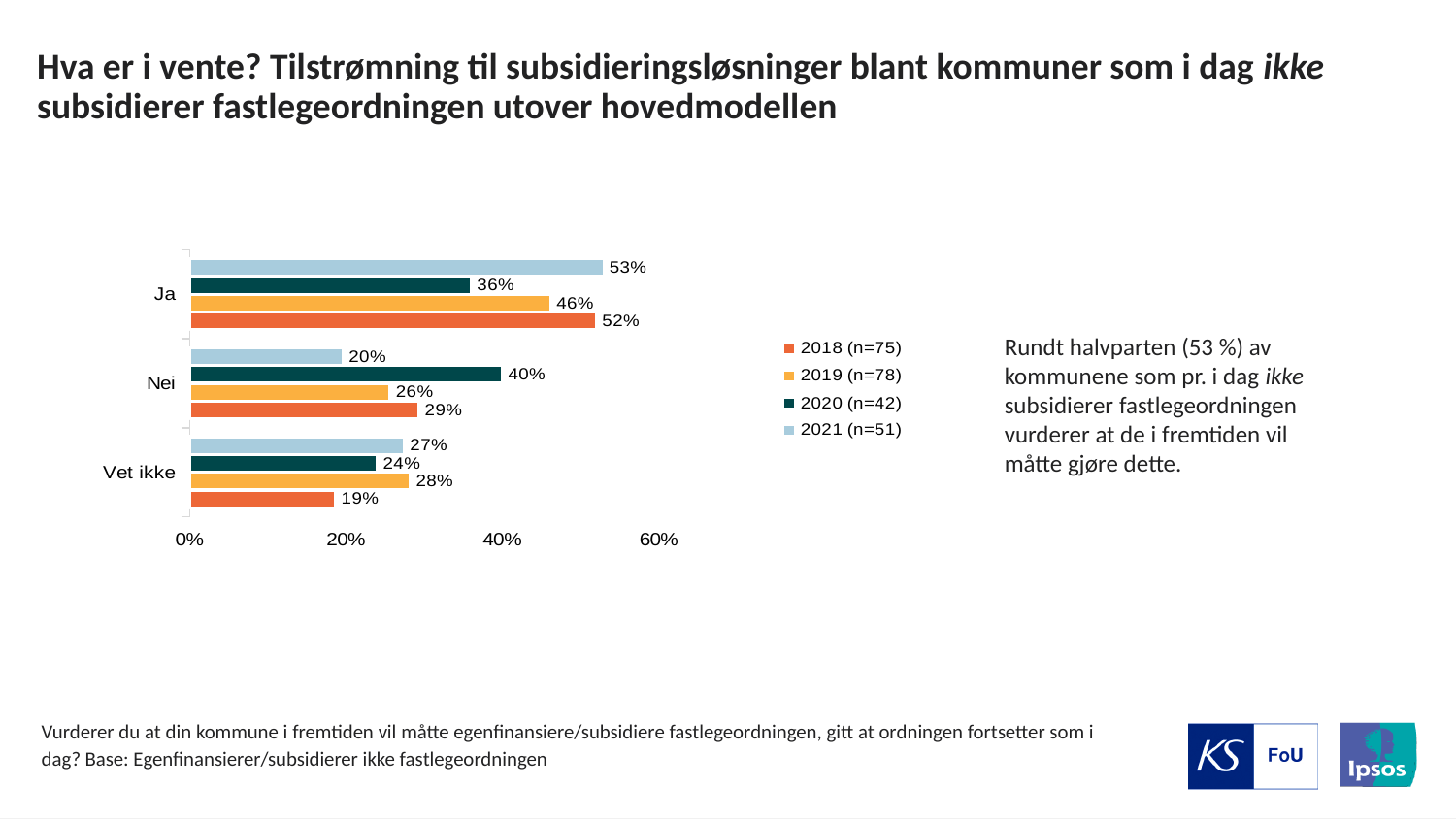
What is the difference between the 2021 (n=51) and 2020 (n=42) values for "Ja"? 17 percentage points How many categories are shown on the chart? 3 How many series does the legend list? 4 What is the value for "Ja" in the 2021 (n=51) series? 53% Which series is shown in light blue in the legend? 2021 (n=51) What is the value for "Nei" in the 2020 (n=42) series? 40% What is the value for "Vet ikke" in the 2018 (n=75) series? 19% What is the value for "Ja" in the 2019 (n=78) series? 46% Which category has the highest value in the 2021 (n=51) series? Ja What kind of chart is shown on the slide? Bar chart Which is larger for "Nei": the 2018 (n=75) value or the 2019 (n=78) value? 2018 (n=75) Which category has the lowest value in the 2018 (n=75) series? Vet ikke